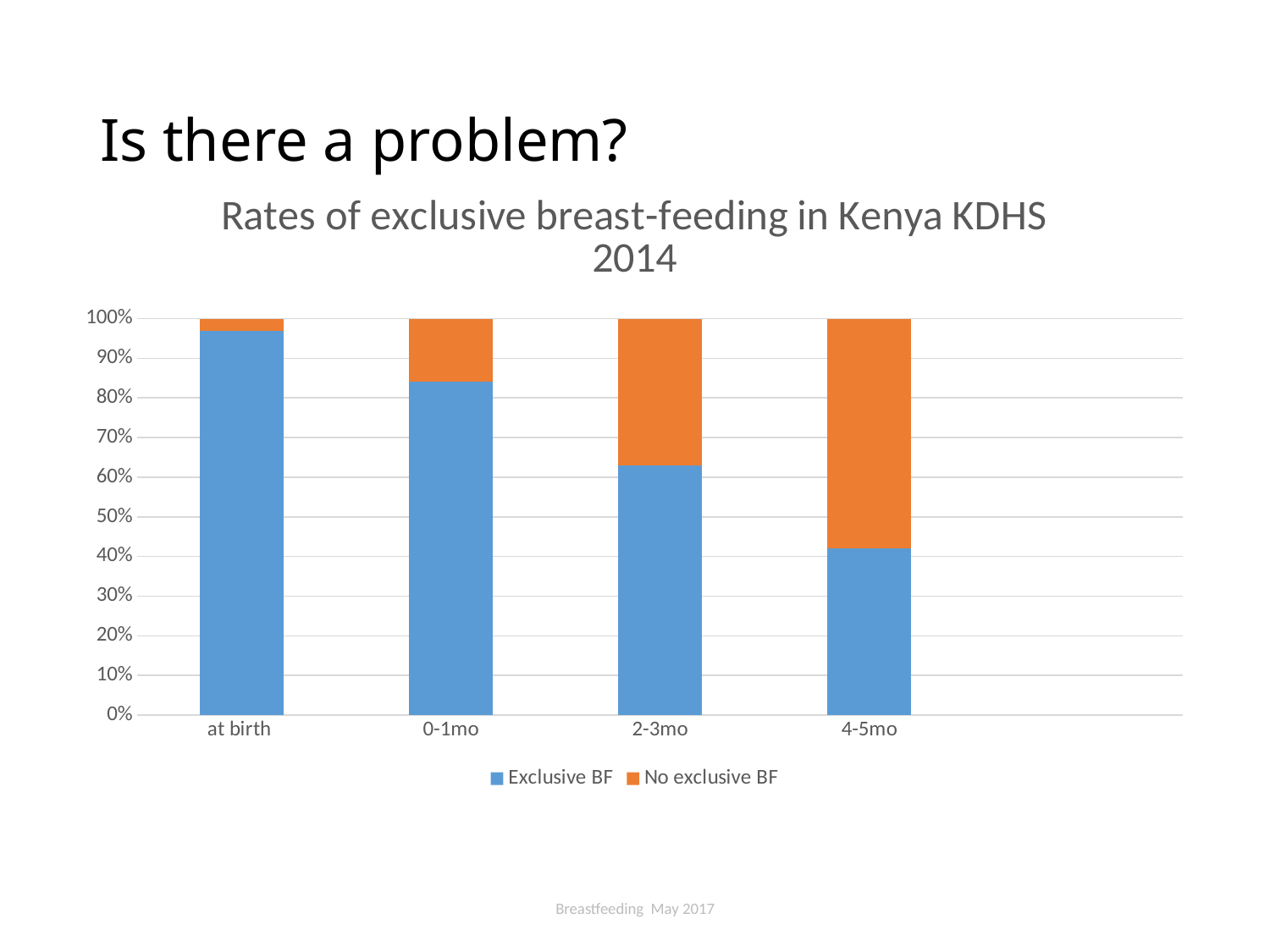
Which category has the largest No exclusive BF share? 4-5mo How many categories are shown on the x axis? 4 Does the Exclusive BF value rise or fall from at birth to 4-5mo? fall Is the Exclusive BF value for 4-5mo greater or less than 50%? less Which is larger, the Exclusive BF value for 0-1mo or for 2-3mo? 0-1mo What is the title of the chart? Rates of exclusive breast-feeding in Kenya KDHS 2014 Which category has the highest Exclusive BF value? at birth Is the Exclusive BF value for 0-1mo greater or less than 80%? greater How many series does the legend list? 2 Which category has the lowest Exclusive BF value? 4-5mo What kind of chart is shown on the slide? stacked bar chart Is the Exclusive BF value for 2-3mo greater or less than 60%? greater